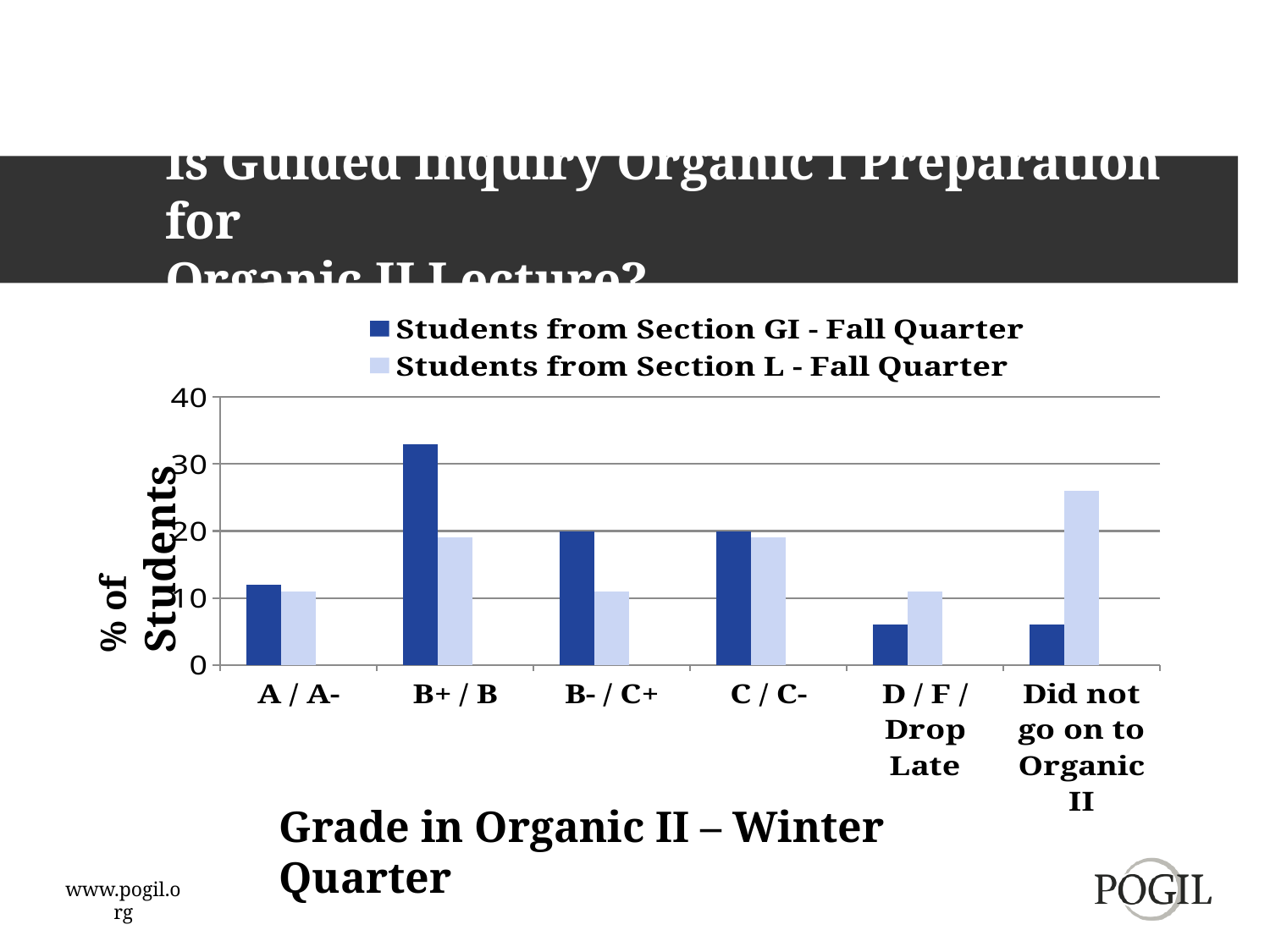
Is the value for Students from Section L - Fall Quarter in the Did not go on to Organic II category greater or less than 20? greater Is the value for Students from Section GI - Fall Quarter in the D / F / Drop Late category greater or less than 10? less What kind of chart is shown on the slide? bar chart How many series does the legend list? 2 Which grade category has the highest value for Students from Section GI - Fall Quarter? B+ / B How many grade categories are shown on the x axis? 6 Is the value for Students from Section GI - Fall Quarter in the B+ / B category greater or less than 30? greater In the B+ / B category, which series has the larger value: Students from Section GI - Fall Quarter or Students from Section L - Fall Quarter? Students from Section GI - Fall Quarter Which category has the highest value for Students from Section L - Fall Quarter? Did not go on to Organic II What is the label of the vertical axis? % of Students In the Did not go on to Organic II category, which series has the larger value: Students from Section GI - Fall Quarter or Students from Section L - Fall Quarter? Students from Section L - Fall Quarter